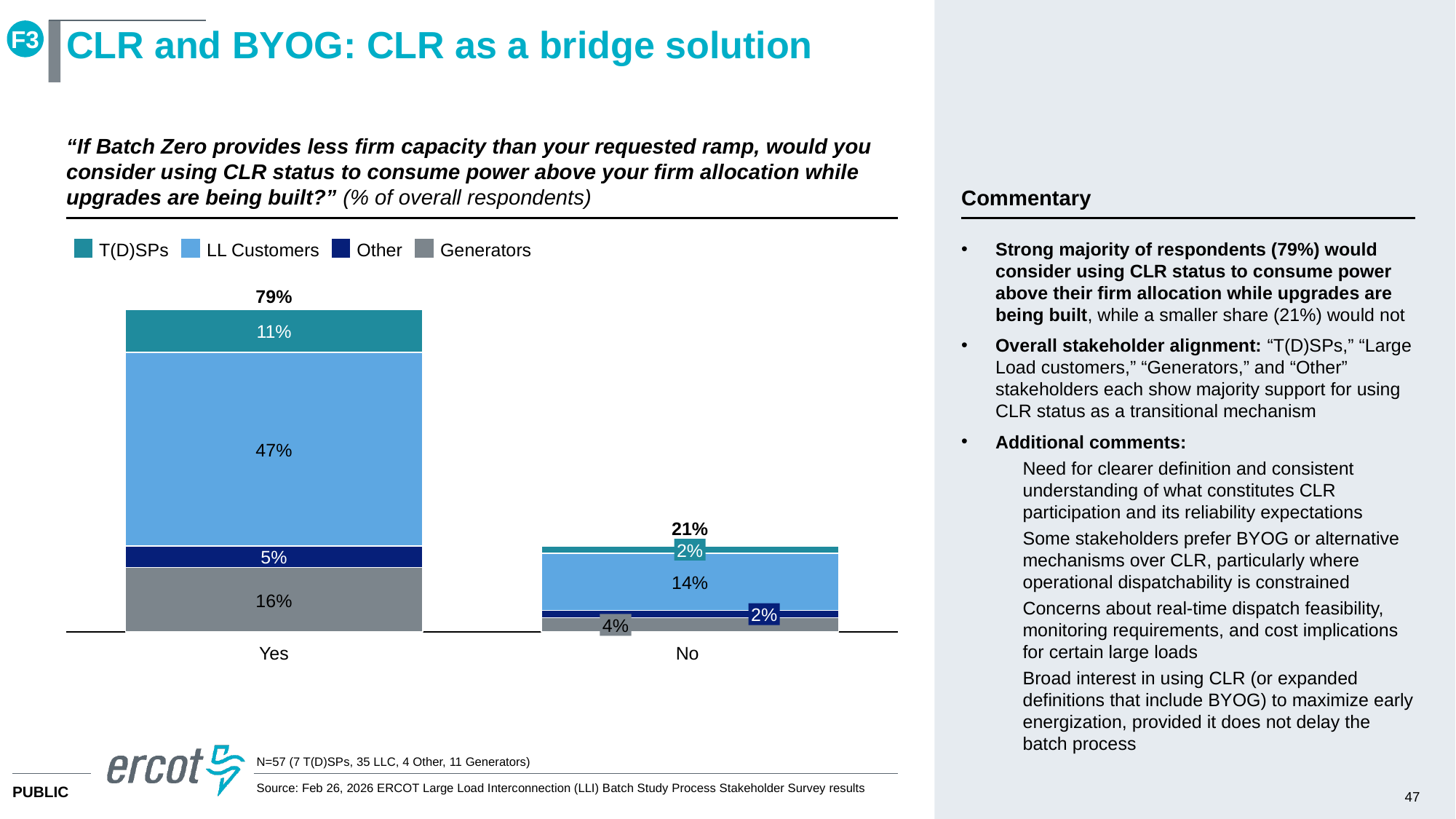
What kind of chart is shown on the slide? Stacked bar chart What is the Generators share within the No bar? 4% What is the difference between the Yes total and the No total? 58 percentage points Which response category has the higher total, Yes or No? Yes What percentage of overall respondents answered Yes? 79% What percentage of overall respondents answered No? 21% How many response categories are shown on the x axis? 2 What is the Other share within the No bar? 2% How many series does the legend list? 4 What is the difference between the LL Customers share in the Yes bar and in the No bar? 33 percentage points What is the T(D)SPs share within the Yes bar? 11% What is the LL Customers share within the Yes bar? 47%